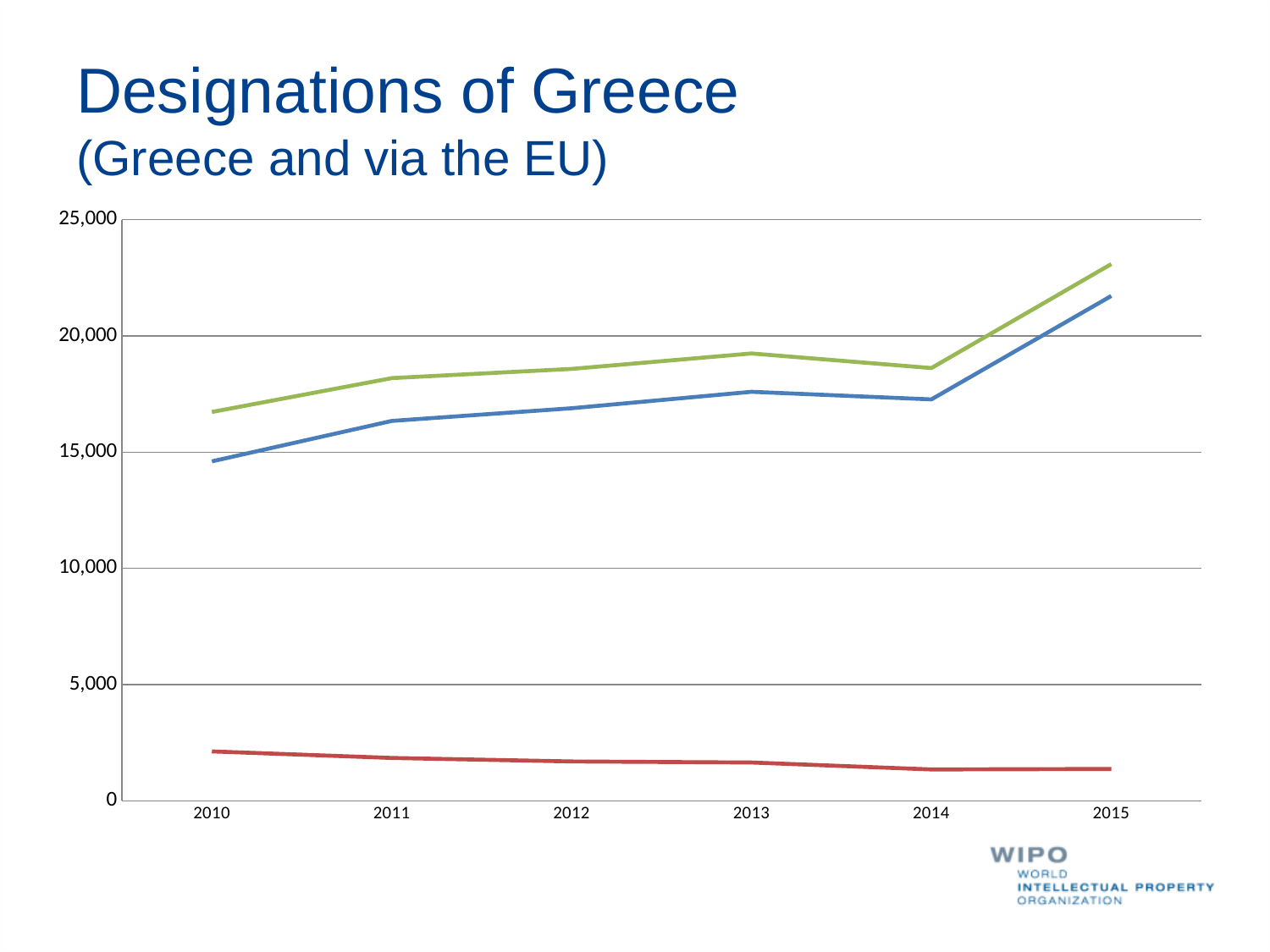
Is the value of the green line in 2015 greater or less than 20,000? greater Is the value of the red line in 2010 greater or less than 5,000? less How many lines are plotted on the chart? 3 Is the value of the green line in 2013 greater or less than 20,000? less In 2015, which line is higher, the green line or the blue line? green line How many years are shown on the x axis of the chart? 6 In which year is the green line at its lowest value? 2010 In which year does the green line reach its highest value? 2015 What kind of chart is shown on the slide? line chart Does the red line rise or fall from 2010 to 2015? fall